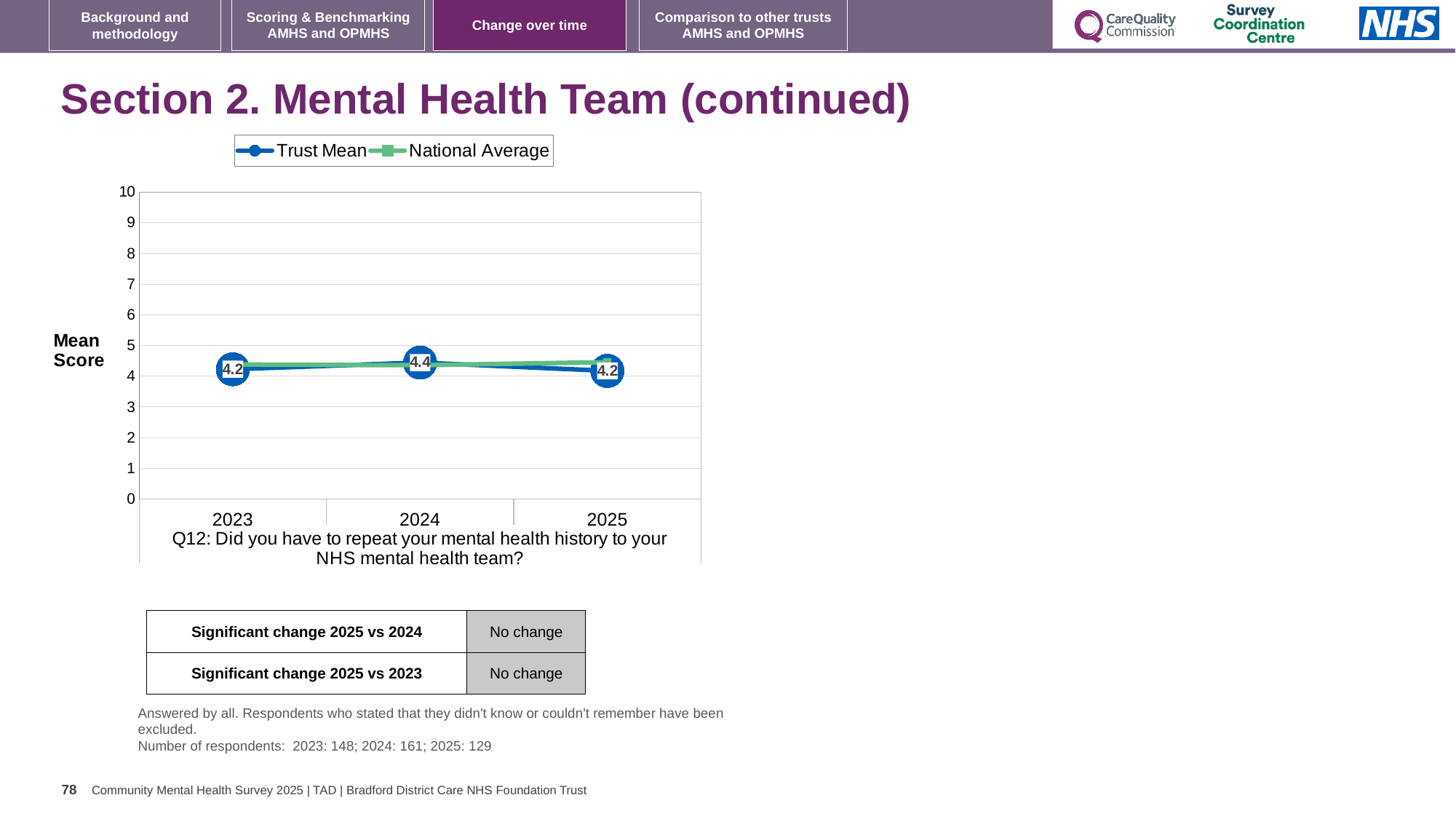
Is the National Average value for 2023 greater or less than 3? greater What is the difference between the Trust Mean in 2024 and in 2025? 0.2 How many series does the legend list? 2 What kind of chart is shown on the slide? Line chart What is the label of the y axis? Mean Score Is the Trust Mean for 2024 larger than the Trust Mean for 2023? Yes What is the Trust Mean score for 2024? 4.4 In which year is the Trust Mean highest? 2024 Is the National Average value for 2025 greater or less than 5? less What is the Trust Mean score for 2025? 4.2 How many years are plotted on the x axis? 3 What is the Trust Mean score for 2023? 4.2